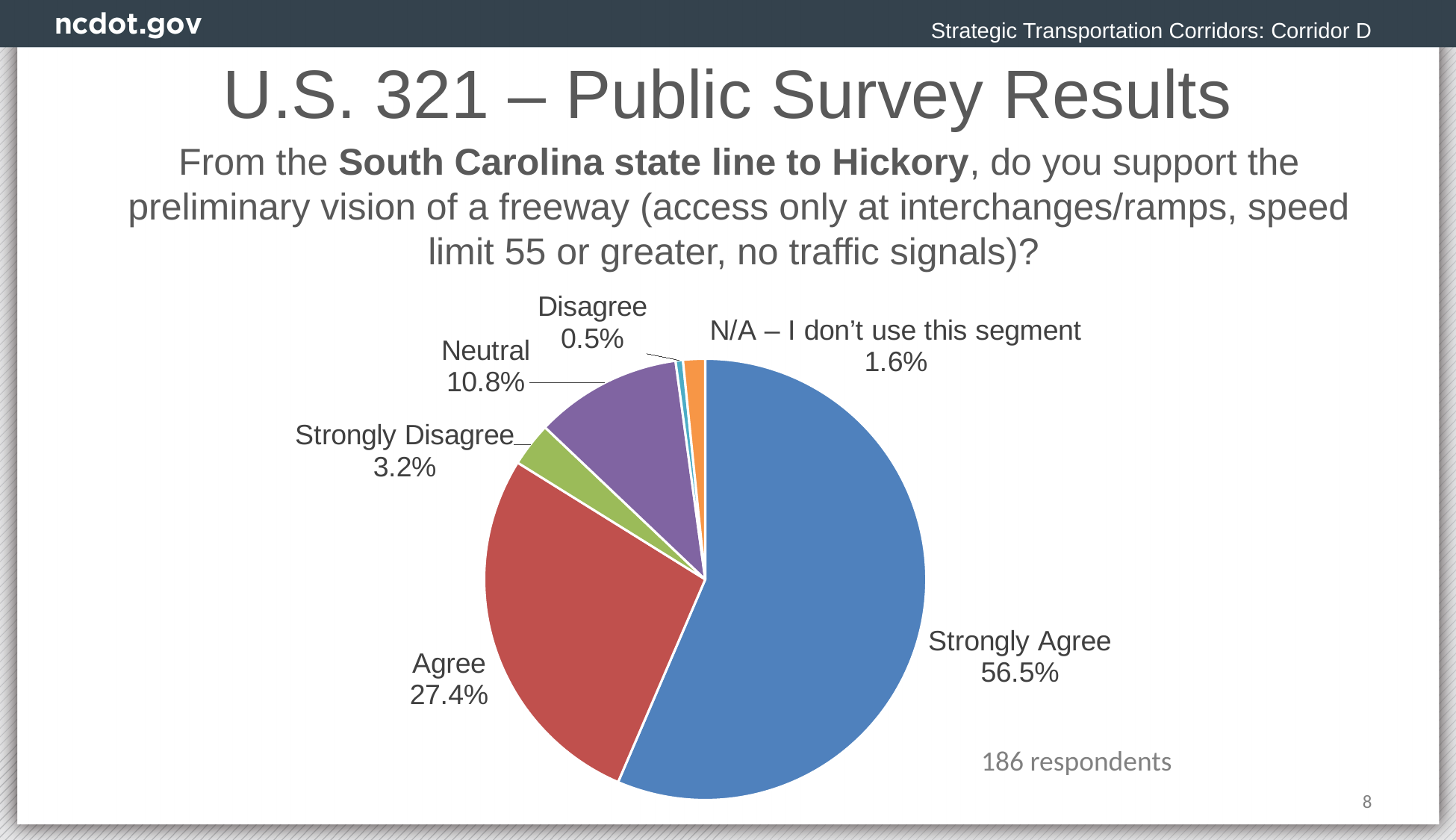
What type of chart is shown on the slide? pie chart Which is larger, the share for Neutral or the share for Strongly Disagree? Neutral Which response category has the largest share of the pie? Strongly Agree What is the difference in percentage points between Strongly Agree and Agree? 29.1 What percentage of respondents answered Agree? 27.4% What percentage of respondents answered Strongly Agree? 56.5% What percentage of respondents answered N/A – I don't use this segment? 1.6% How many respondents does the chart note as having answered the survey? 186 respondents What percentage of respondents answered Neutral? 10.8% Which response category has the smallest share of the pie? Disagree How many slices does the pie chart have? 6 What percentage of respondents answered Strongly Disagree? 3.2%